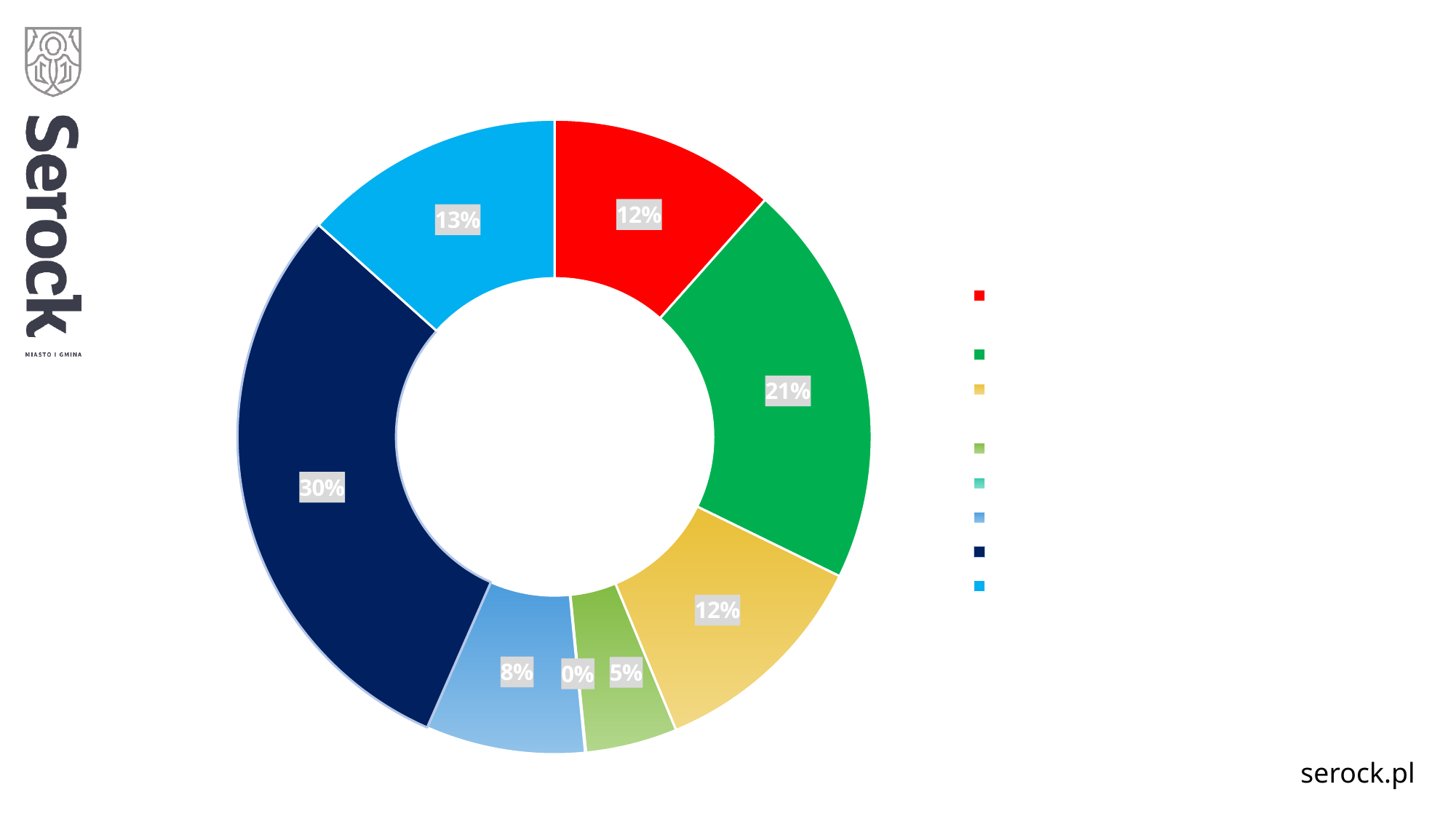
Which colour slice has the largest share? dark navy (30%) How many entries does the legend list? 8 What percentage is shown on the green slice? 21% Which colour slice has the smallest share? teal (0%) How many slices does the doughnut chart have? 8 What is the difference in percentage points between the dark navy slice and the green slice? 9 percentage points What percentage is shown on the light blue slice at the bottom? 8% What percentage is shown on the dark navy slice? 30% Which slice is larger, the green one or the cyan one at the top left? the green one (21%) What percentage is shown on the light green slice? 5% What percentage is shown on the red slice? 12% What kind of chart is shown on the slide? doughnut (pie) chart